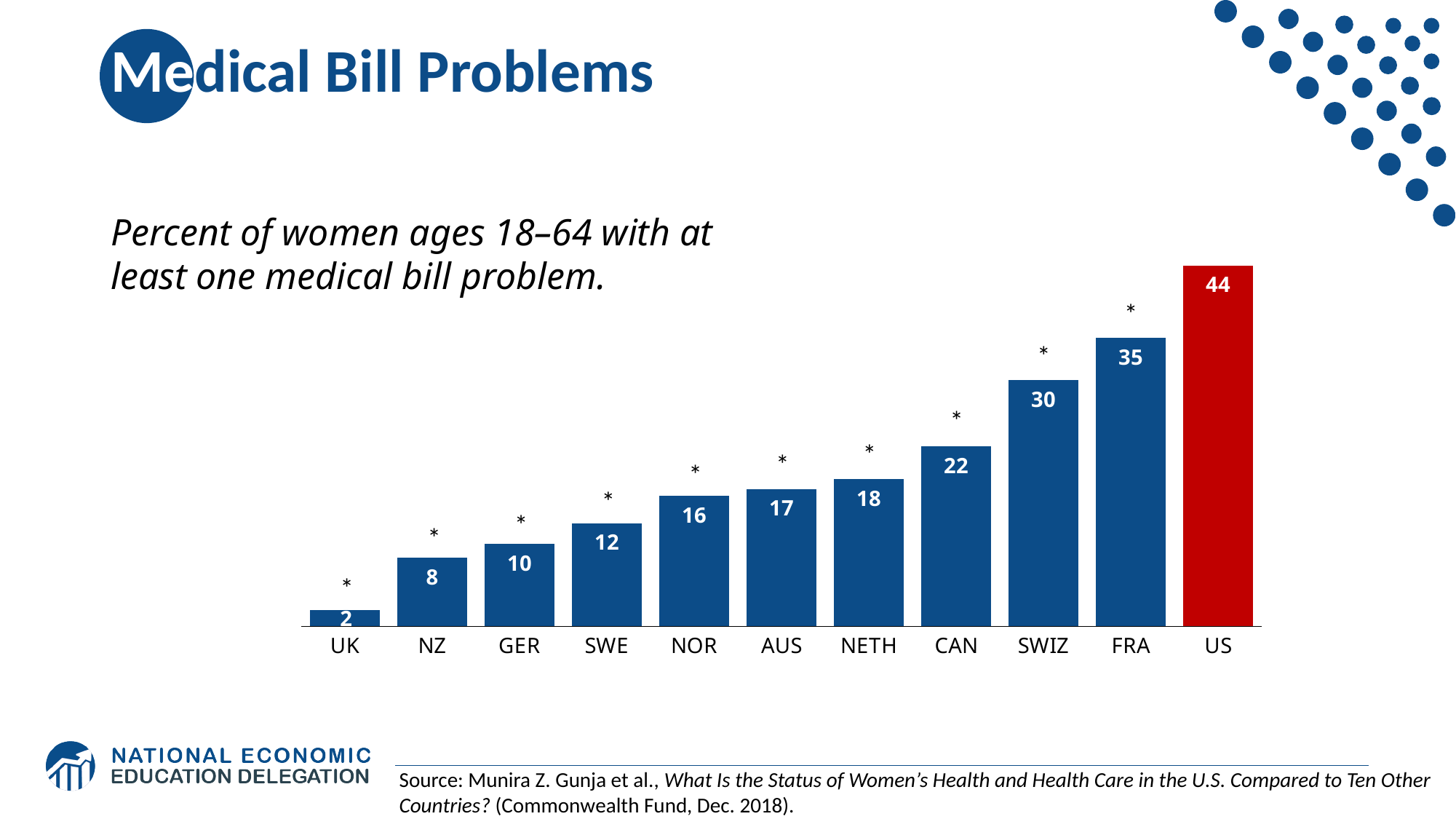
What is the difference between the values for SWIZ and NZ? 22 Which bar is coloured red rather than blue? US Do the values rise or fall from left to right along the x axis? Rise Which country has the highest value? US What is the value for CAN? 22 What is the difference between the values for the US and FRA? 9 Which has a larger value, NOR or NETH? NETH Which country has the lowest value? UK What kind of chart is this? Bar chart What is the value for the US? 44 What is the value for SWE? 12 How many countries are shown on the chart? 11